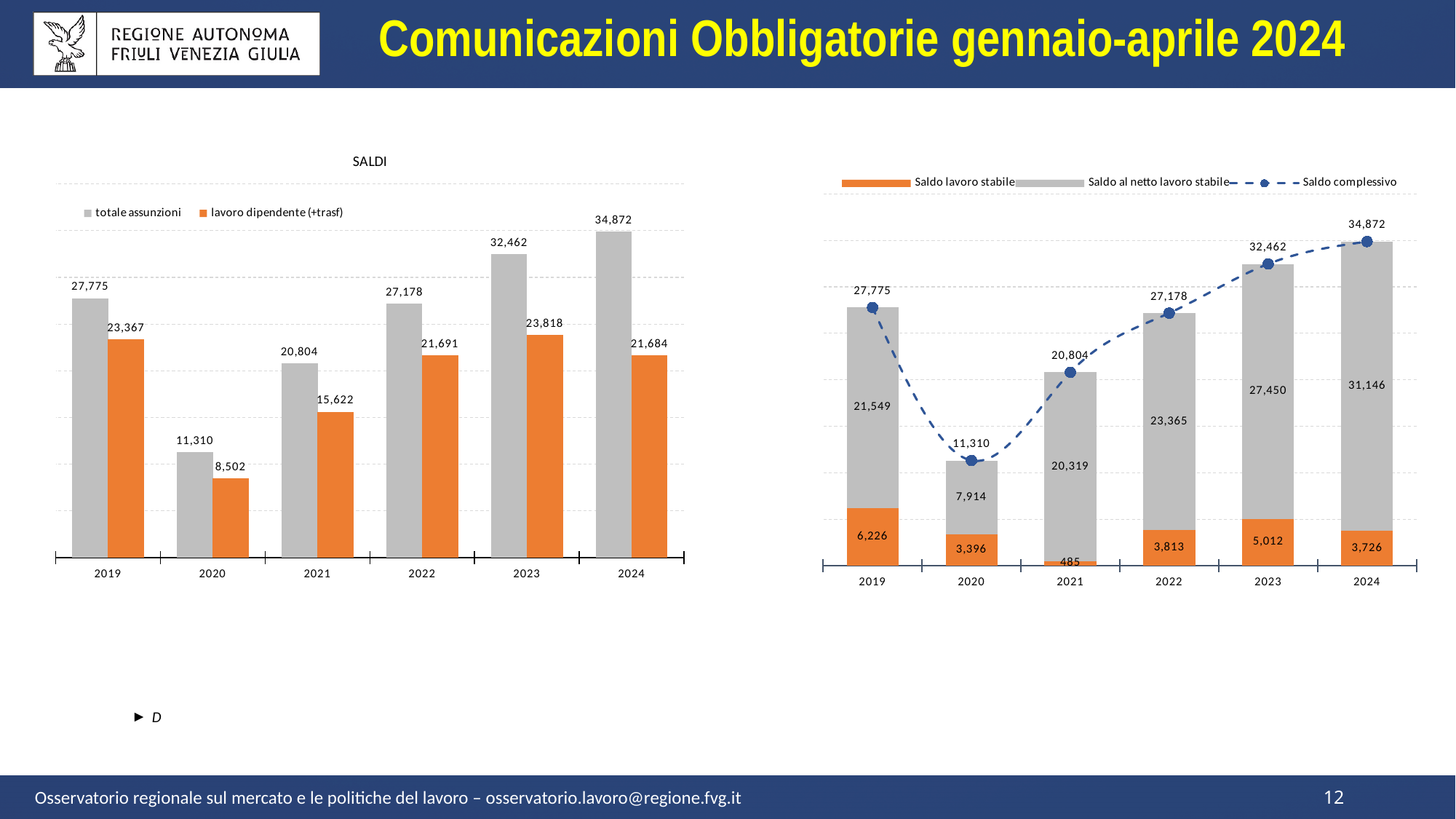
In the left chart titled SALDI, which year has the highest lavoro dipendente (+trasf) value? 2023 In the right chart, what is the value of Saldo al netto lavoro stabile for 2024? 31,146 In the right chart, what is the total of the stacked bar for 2022? 27,178 In the right chart, what is the value of Saldo lavoro stabile for 2021? 485 In the left chart titled SALDI, what is the difference between totale assunzioni and lavoro dipendente (+trasf) in 2019? 4,408 In the right chart, how many years are shown on the x axis? 6 In the left chart titled SALDI, which year has the lowest totale assunzioni? 2020 In the left chart titled SALDI, how many series does the legend list? 2 In the left chart titled SALDI, what is the value of lavoro dipendente (+trasf) for 2021? 15,622 In the left chart titled SALDI, what is the value of totale assunzioni for 2023? 32,462 In the right chart, which year has the highest Saldo lavoro stabile? 2019 What kind of chart is the left chart titled SALDI? Bar chart